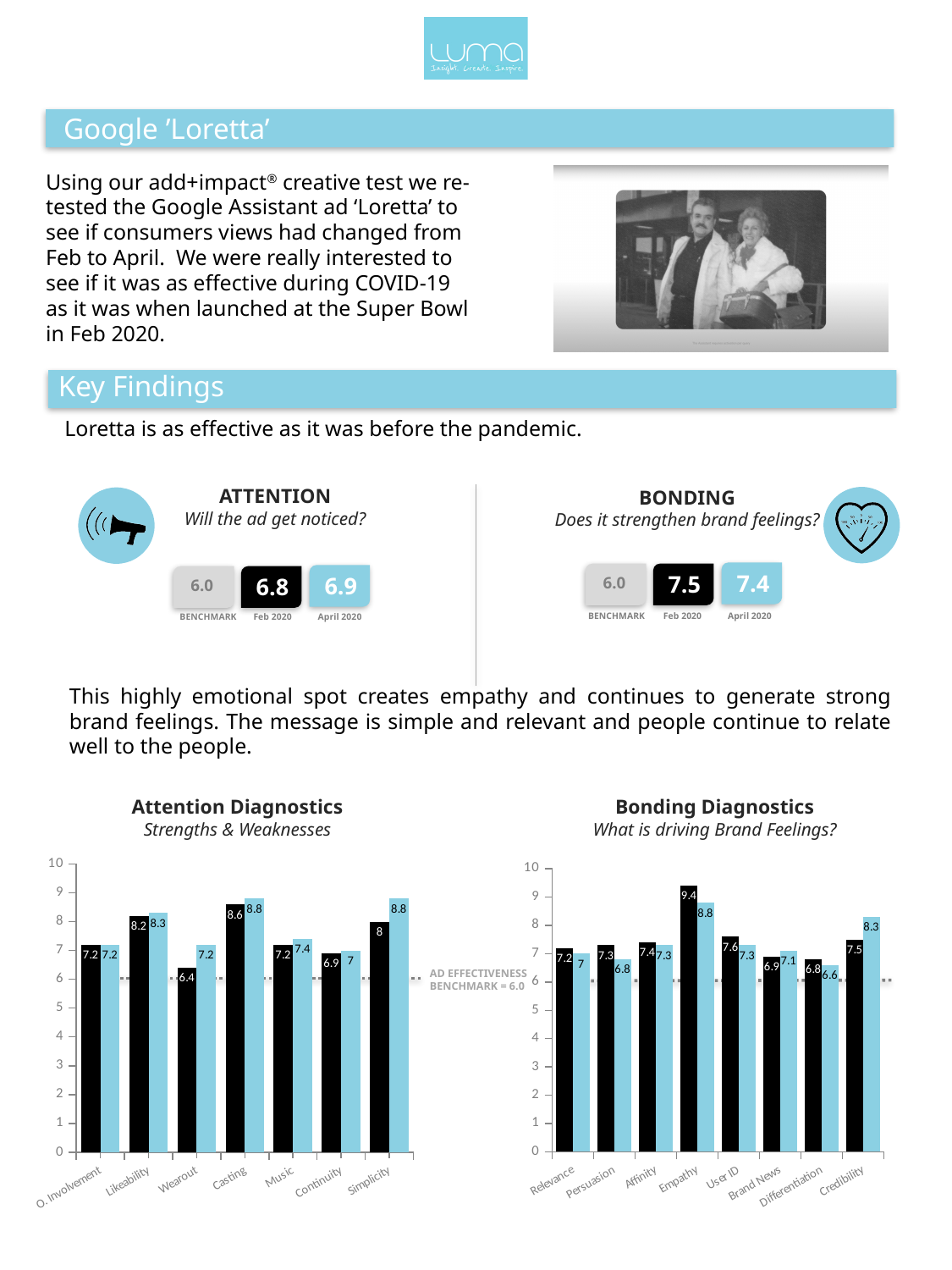
In the Attention Diagnostics chart, what is the value of the blue bar for Simplicity? 8.8 In the Bonding Diagnostics chart, what is the value of the black bar for Empathy? 9.4 What type of chart is the Attention Diagnostics chart? bar chart In the Attention Diagnostics chart, which category has the lowest black bar? Wearout In the Attention Diagnostics chart, what is the difference between the blue bar and the black bar for Wearout? 0.8 What value does the dashed Ad Effectiveness Benchmark line on the charts represent? 6.0 In the Attention Diagnostics chart, what is the value of the black bar for Wearout? 6.4 How many categories are shown on the x axis of the Bonding Diagnostics chart? 8 In the Bonding Diagnostics chart, which category has the highest black bar? Empathy In the Bonding Diagnostics chart, which is larger for Persuasion: the black bar or the blue bar? the black bar In the Bonding Diagnostics chart, what is the value of the blue bar for Credibility? 8.3 How many categories are shown on the x axis of the Attention Diagnostics chart? 7